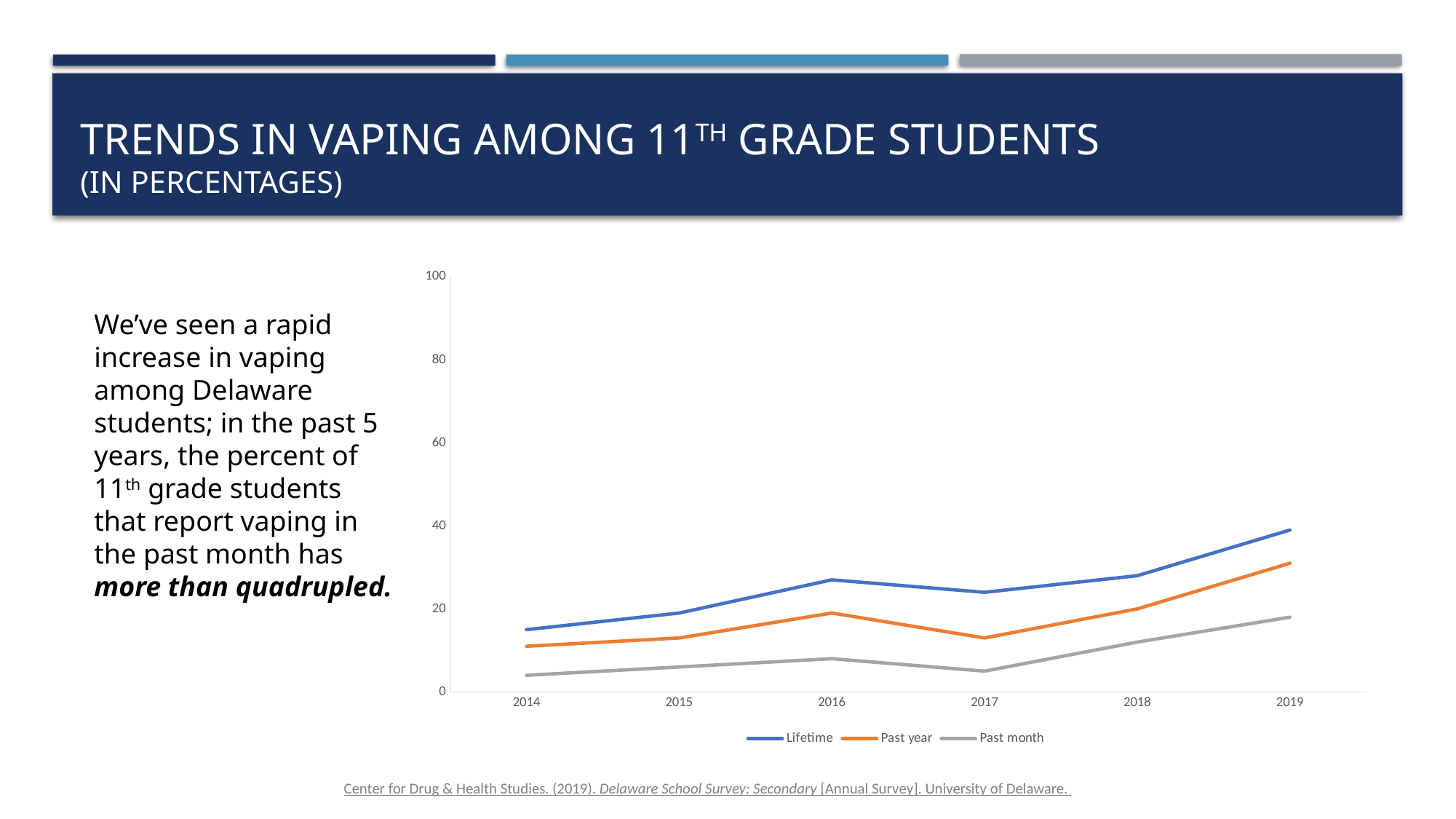
In which year does the Lifetime series reach its highest value? 2019 Is the value for Past year in 2019 greater or less than 20? greater In which year is the Past month series at its lowest value? 2014 Is the value for Lifetime in 2016 greater or less than 20? greater Which series is plotted with the blue line? Lifetime How many series does the chart legend list? 3 How many years are plotted along the x axis of the chart? 6 Is the value for Lifetime in 2014 greater or less than 20? less In 2019, which series has the larger value, Lifetime or Past month? Lifetime Do the values of the Past month series rise or fall from 2017 to 2019? rise What kind of chart is shown on the slide? line chart